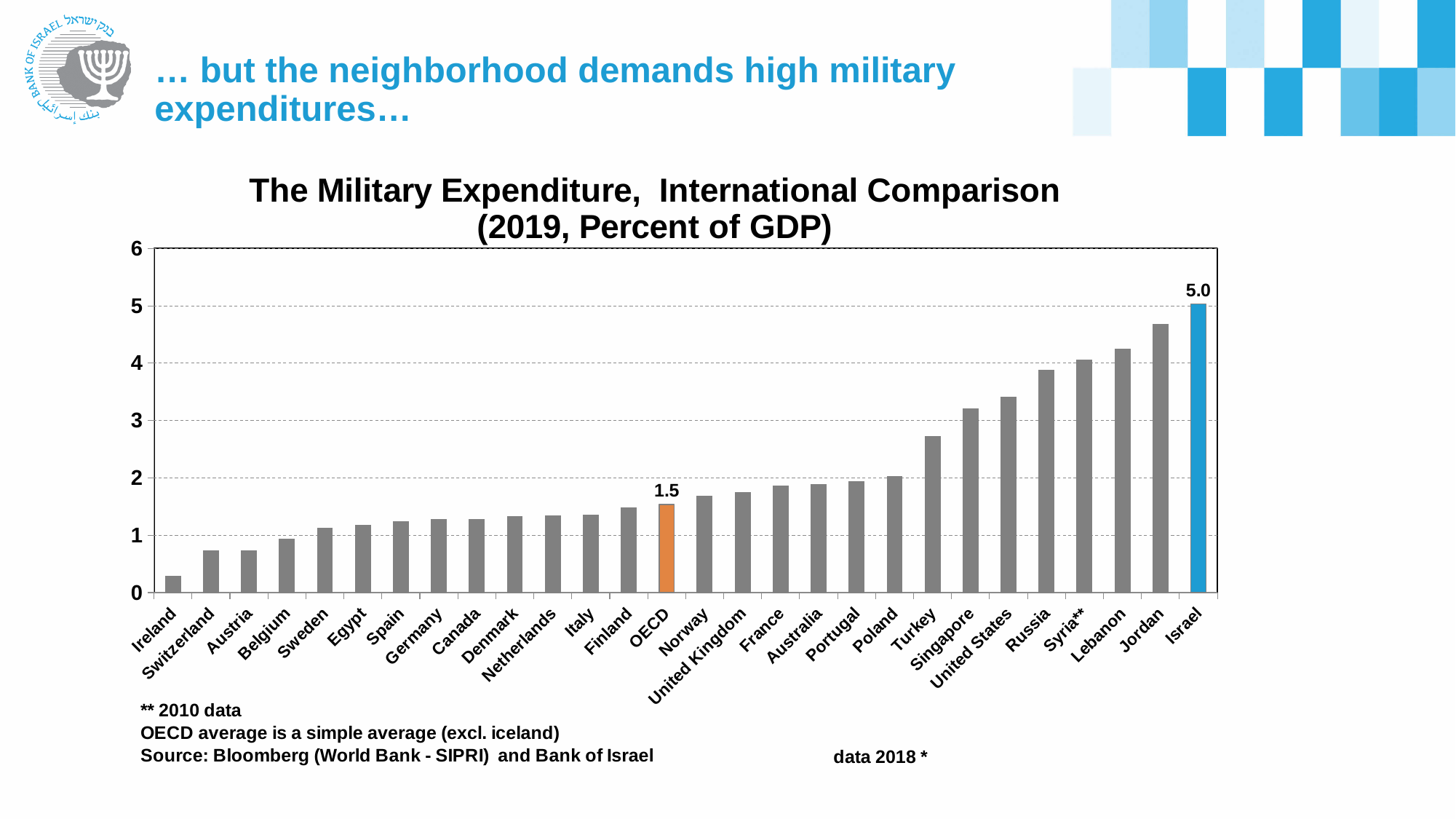
What kind of chart is shown on the slide? Bar chart Which is larger, the value for Jordan or the value for Turkey? Jordan Which country has the lowest military expenditure as a percent of GDP? Ireland Is the value for Ireland greater or less than 1? less Is the value for Jordan greater or less than 4? greater What is the value for OECD? 1.5 What is the value for Israel? 5.0 What is the difference between the values for Israel and OECD? 3.5 Do the values rise or fall moving from left to right along the x axis? Rise Is the value for Turkey greater or less than 3? less Which country has the highest military expenditure as a percent of GDP? Israel How many countries/categories are shown on the x axis? 28